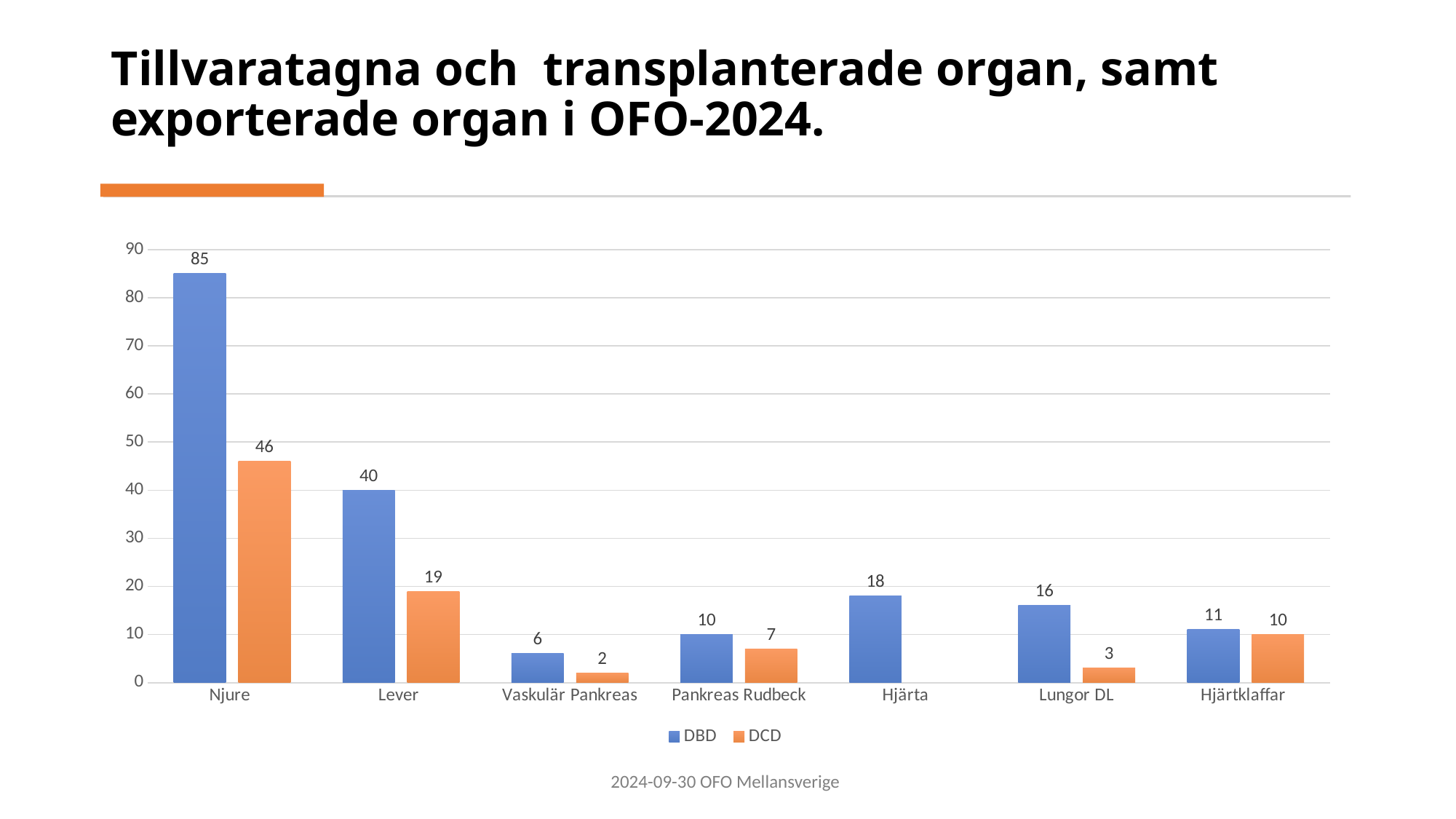
Which category has the highest DBD value? Njure What is the difference between the DBD and DCD values for Njure? 39 Which is larger for Hjärtklaffar, the DBD value or the DCD value? DBD What colour are the DCD bars? Orange What is the DBD value for Njure? 85 What is the DCD value for Lever? 19 What kind of chart is shown on the slide? Bar chart What is the DCD value for Lungor DL? 3 Which category has no DCD bar? Hjärta How many categories are shown on the x axis? 7 How many series does the legend list? 2 Which category has the lowest DCD value among those with a DCD bar? Vaskulär Pankreas